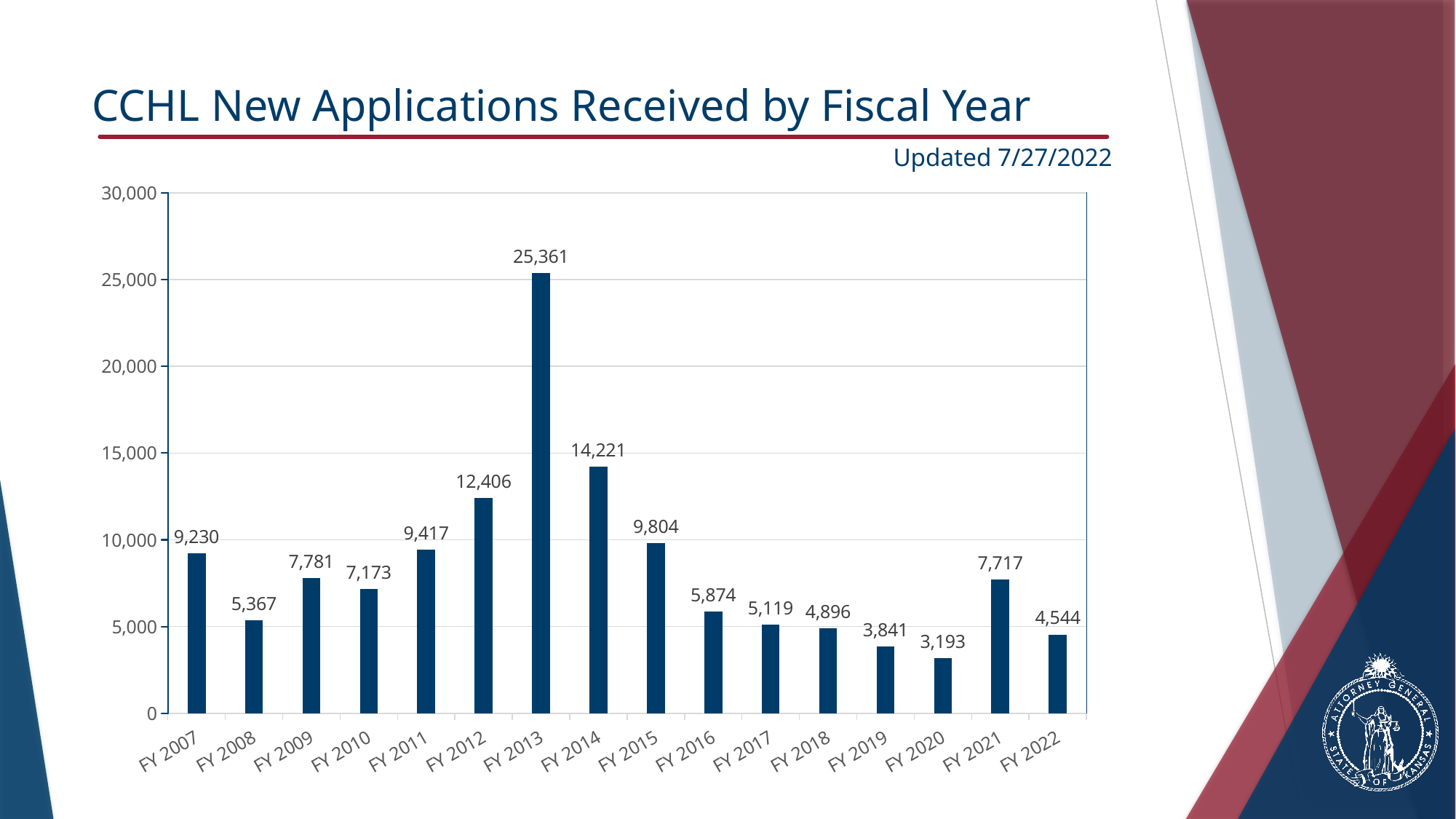
Which fiscal year has the highest number of new applications received? FY 2013 What kind of chart is shown on the slide? bar chart Do the values rise or fall from FY 2013 to FY 2020? fall Which fiscal year has a larger value, FY 2012 or FY 2015? FY 2012 How many new applications were received in FY 2013? 25,361 What is the value shown for FY 2020? 3,193 Which fiscal year has the lowest number of new applications received? FY 2020 How many new applications were received in FY 2022? 4,544 How many fiscal years are shown on the x axis? 16 Is the value for FY 2014 greater or less than 15,000? less How much higher is the value for FY 2021 than the value for FY 2020? 4,524 What is the difference between the values for FY 2013 and FY 2014? 11,140